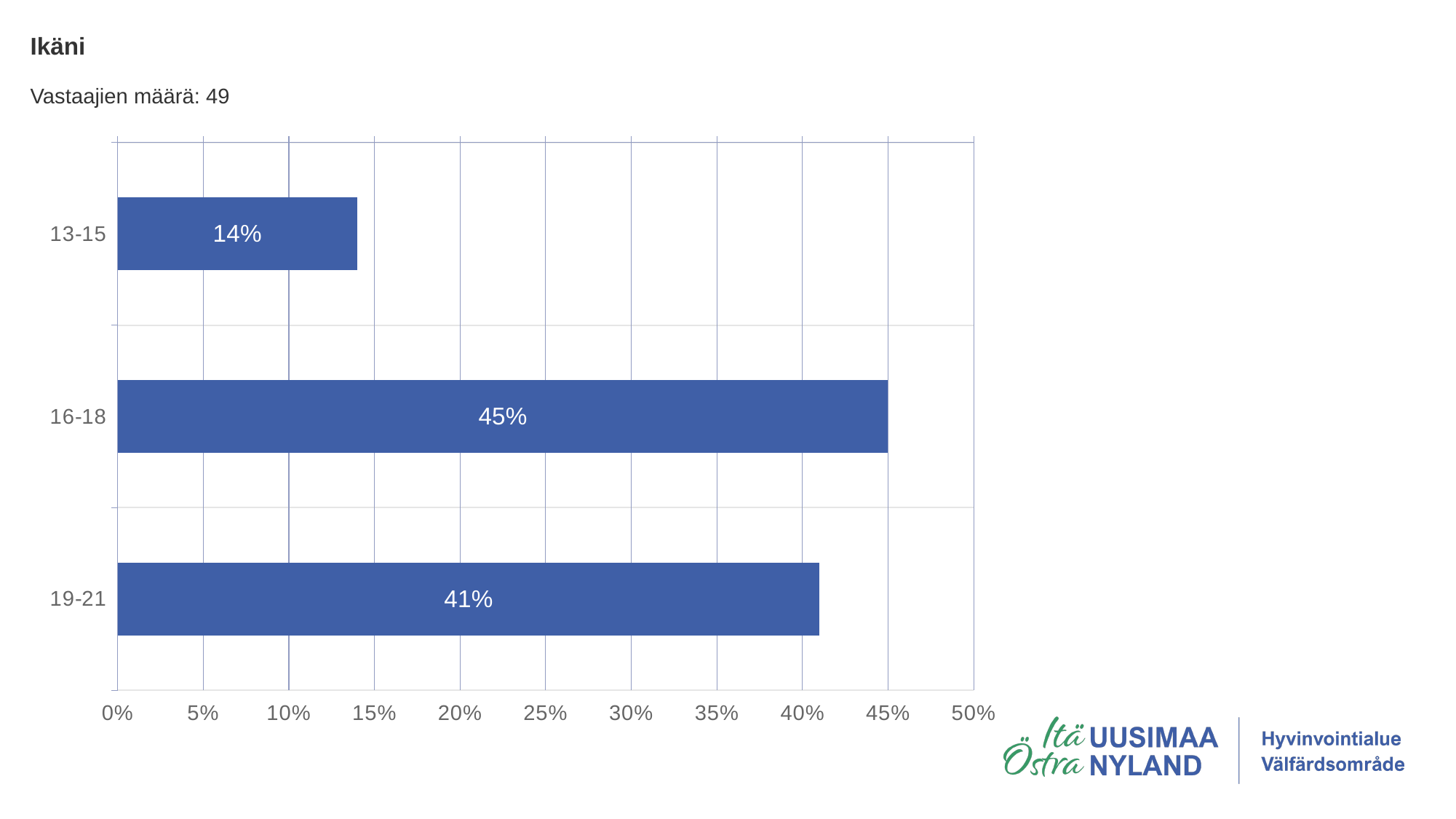
What is the difference between the values for 16-18 and 13-15? 31% What is the value for the 19-21 age group? 41% What is the difference between the values for 16-18 and 19-21? 4% Which age group has the highest value? 16-18 Is the value for 19-21 greater or less than 40%? greater What is the value for the 13-15 age group? 14% Which age group has the lowest value? 13-15 What is the title of the chart? Ikäni What kind of chart is shown on the slide? bar chart What is the value for the 16-18 age group? 45% How many age groups are shown in the chart? 3 Which is larger, the value for 13-15 or the value for 19-21? 19-21